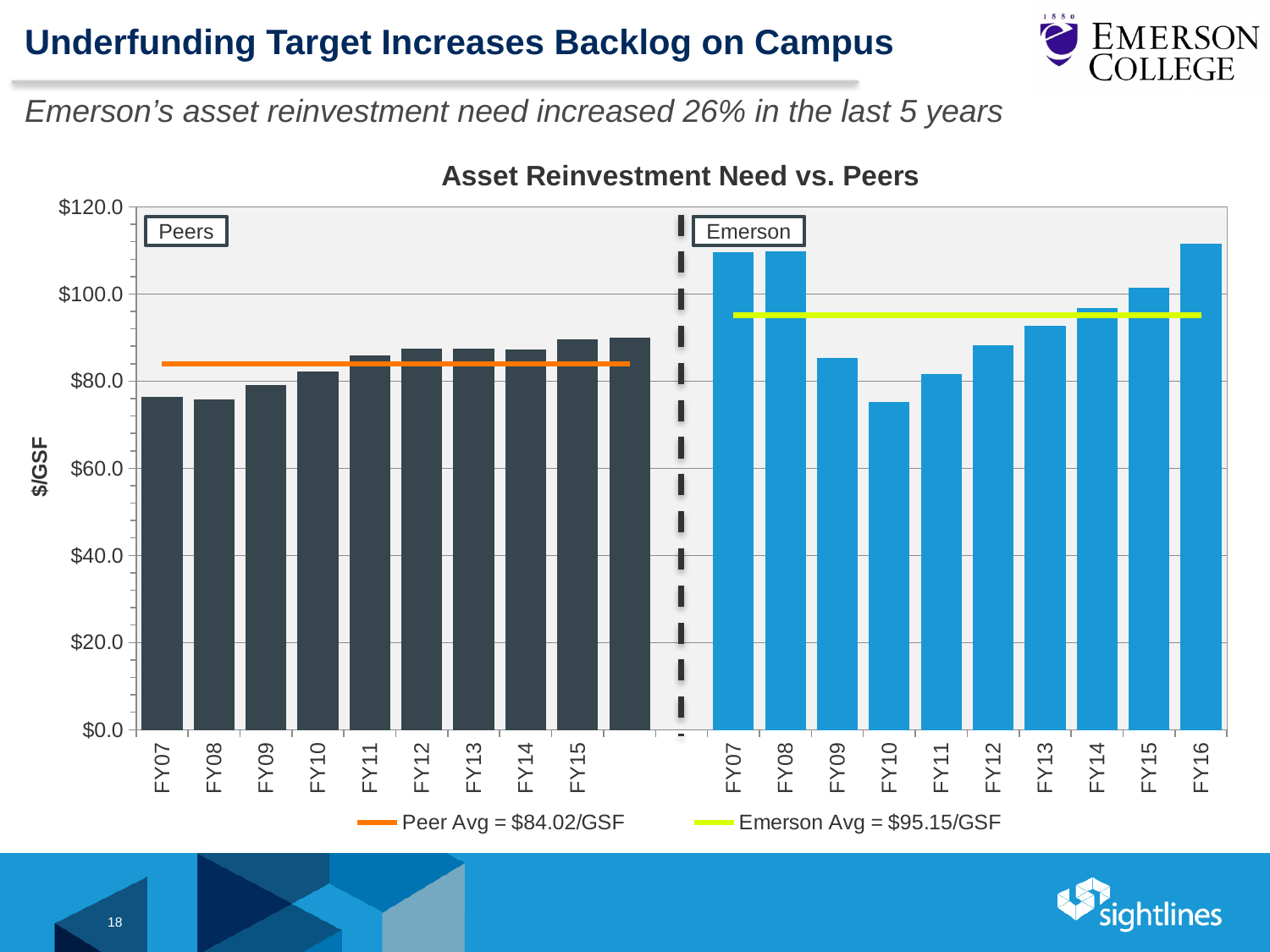
Which fiscal year has the lowest value for Emerson? FY10 According to the legend, what is the Emerson Avg value? $95.15/GSF How many fiscal years are plotted for Peers? 9 What is the title of the chart? Asset Reinvestment Need vs. Peers Is the value for Emerson in FY16 greater or less than $100.0? greater What kind of chart is shown on the slide? Bar chart According to the legend, what is the Peer Avg value? $84.02/GSF What is the difference between the Emerson Avg and the Peer Avg shown in the legend? $11.13/GSF How many fiscal years are plotted for Emerson? 10 How many entries does the legend list? 2 Which is larger, the Emerson value for FY09 or the Emerson value for FY10? FY09 Is the value for Peers in FY07 greater or less than $80.0? less